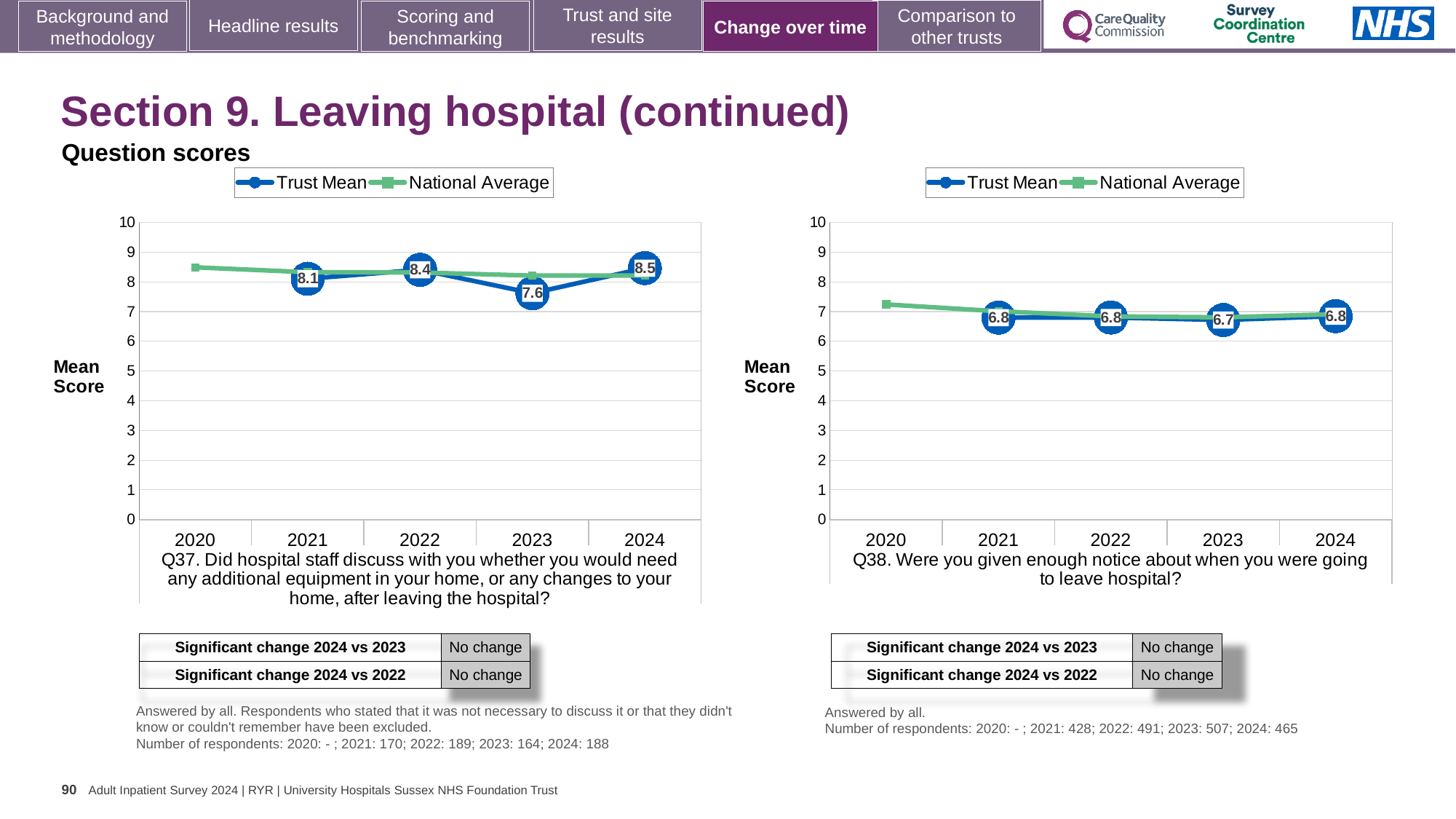
In the Q37 chart (left), which year has the highest Trust Mean score? 2024 In the Q37 chart (left), which year has the lowest Trust Mean score? 2023 How many years are shown on the x axis of the Q37 chart (left)? 5 In the Q37 chart (left), what is the difference between the Trust Mean scores for 2024 and 2023? 0.9 What type of chart is used for the Q38 chart (right)? Line chart How many series does the legend of the Q38 chart (right) list? 2 In the Q38 chart (right), what is the Trust Mean score for 2023? 6.7 In the Q38 chart (right), what is the Trust Mean score for 2021? 6.8 In the Q37 chart (left), is the Trust Mean score for 2022 larger or smaller than the score for 2021? larger In the Q37 chart (left), what is the Trust Mean score for 2023? 7.6 In the Q38 chart (right), is the National Average value for 2020 greater or less than 7? greater In the Q37 chart (left), what is the Trust Mean score for 2024? 8.5